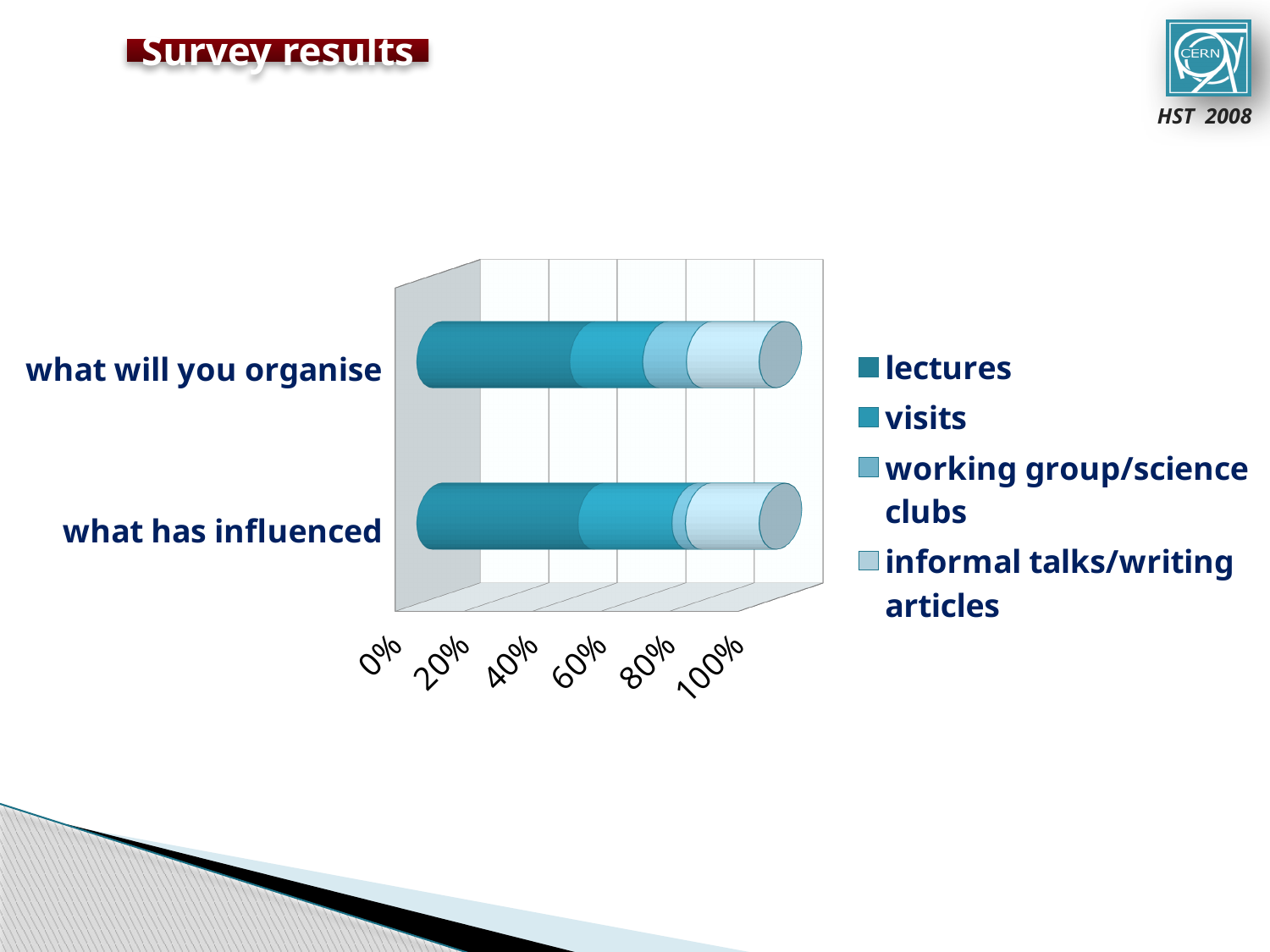
What are the two categories shown on the vertical axis of the chart? what will you organise; what has influenced In the 'what has influenced' bar, which series has the smallest segment? working group/science clubs In the 'what will you organise' bar, which series has the smallest segment? working group/science clubs Is the lectures segment in the 'what has influenced' bar greater or less than 20%? greater Is the working group/science clubs segment in the 'what has influenced' bar greater or less than 20%? less How many series does the legend list? 4 What kind of chart is shown on the slide? stacked bar chart How many categories are plotted on the chart? 2 In the 'what has influenced' bar, which series has the largest segment? lectures Which series is listed last in the chart legend? informal talks/writing articles In the 'what will you organise' bar, which series has the largest segment? lectures In the 'what has influenced' bar, which segment is larger: visits or working group/science clubs? visits